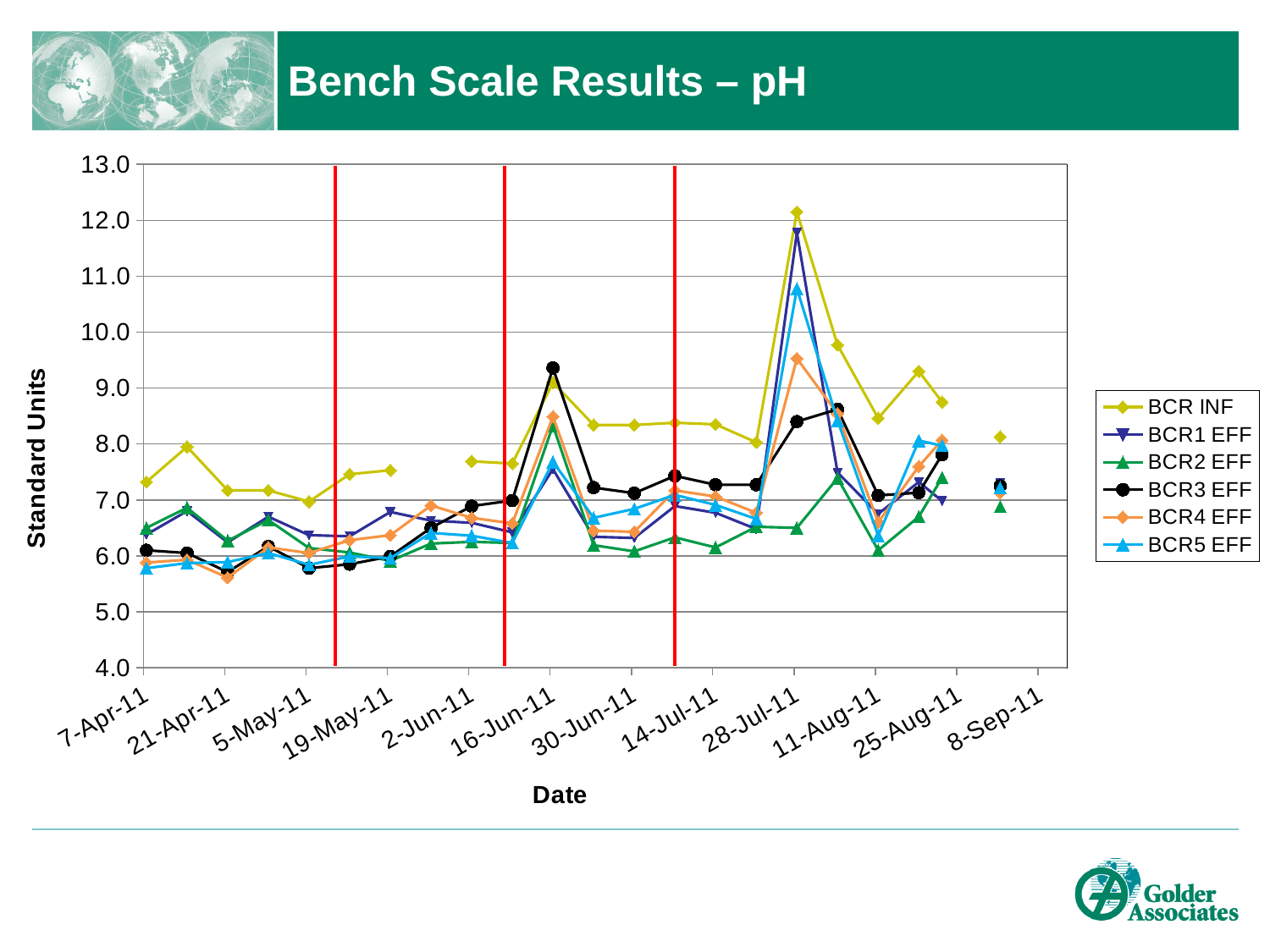
Is the value for BCR5 EFF at 28-Jul-11 greater or less than 10.0? greater How many date labels are shown on the x axis? 12 What is the title of the y axis? Standard Units Is the value for BCR INF at 7-Apr-11 greater or less than 7.0? greater What kind of chart is shown on the slide? line chart Is the value for BCR3 EFF at 16-Jun-11 greater or less than 9.0? greater At 28-Jul-11, which is larger: BCR INF or BCR2 EFF? BCR INF How many series does the legend list? 6 Which series reaches the highest value anywhere on the chart? BCR INF How many vertical red lines are drawn on the chart? 3